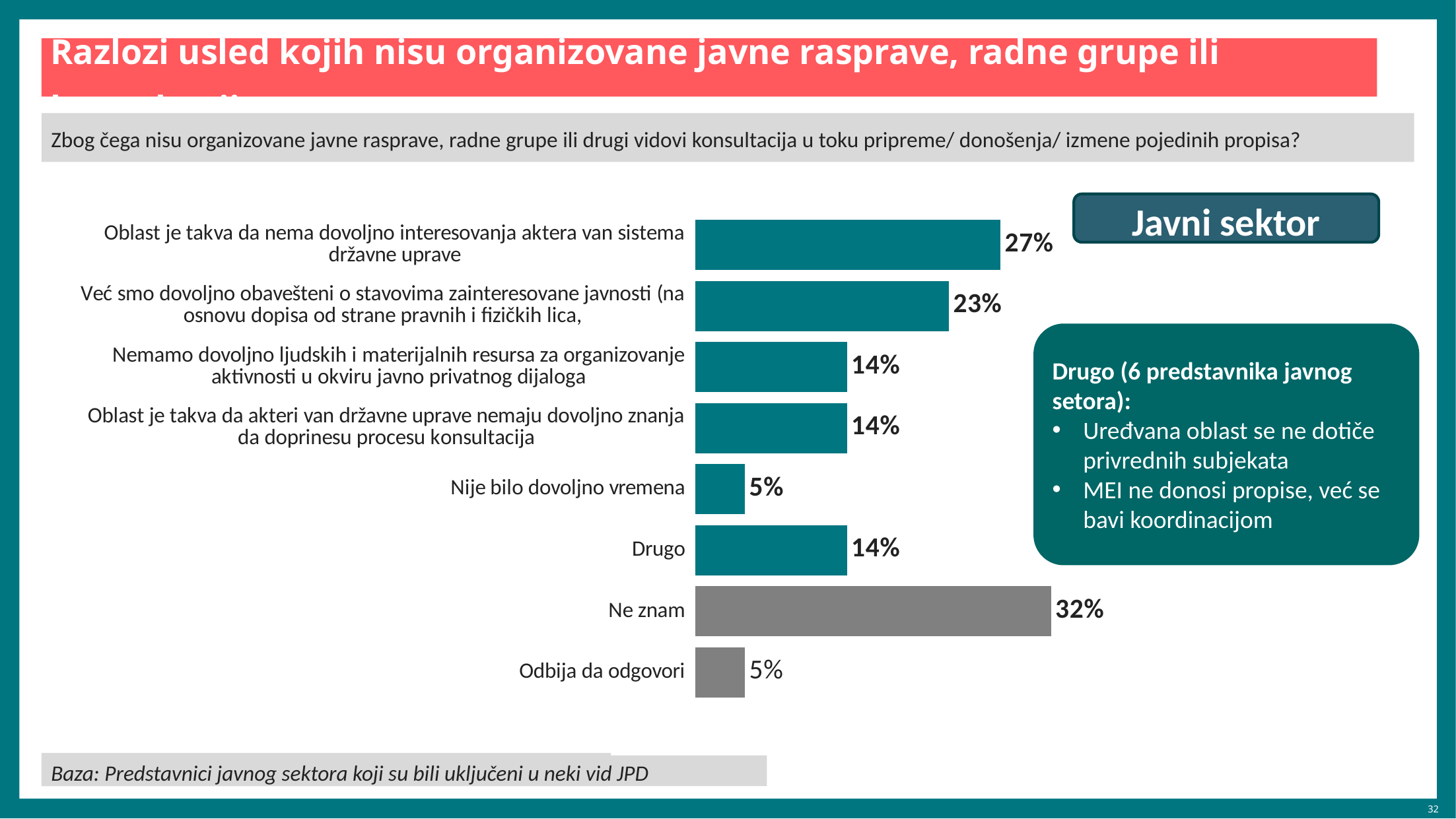
What is the value for "Oblast je takva da nema dovoljno interesovanja aktera van sistema državne uprave"? 27% What is the value for "Nije bilo dovoljno vremena"? 5% What kind of chart is shown on the slide? Bar chart What is the value for "Drugo"? 14% Which category has the highest value? Ne znam Which is larger, the value for "Drugo" or the value for "Odbija da odgovori"? Drugo What is the value for "Ne znam"? 32% What is the difference between the values for "Već smo dovoljno obavešteni o stavovima zainteresovane javnosti" and "Nije bilo dovoljno vremena"? 18% What is the value for "Već smo dovoljno obavešteni o stavovima zainteresovane javnosti"? 23% Which two categories are shown with grey bars instead of teal? Ne znam and Odbija da odgovori How many categories are shown in the chart? 8 What is the difference between the values for "Ne znam" and "Oblast je takva da nema dovoljno interesovanja aktera van sistema državne uprave"? 5%